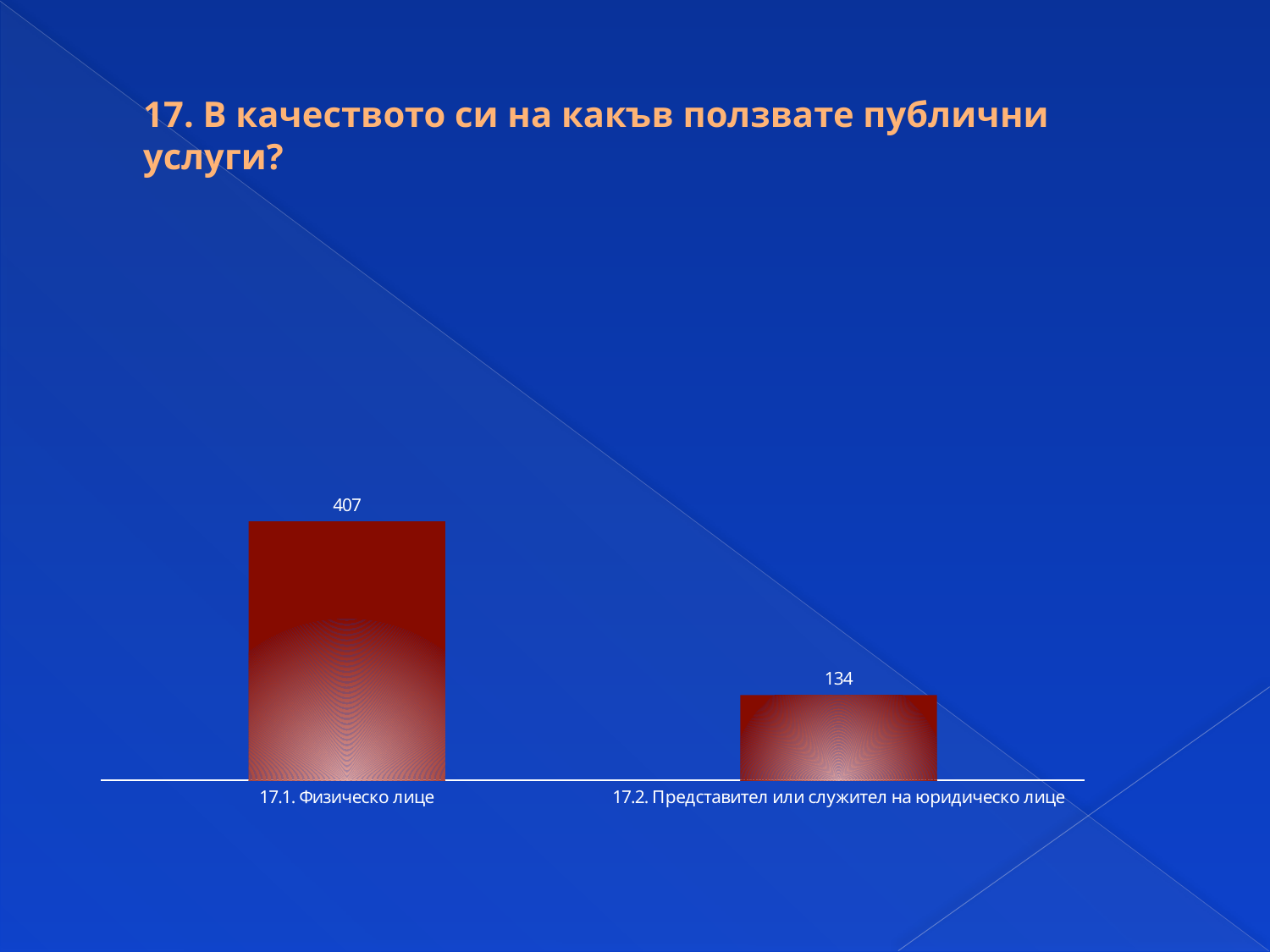
What is the difference between the values for "17.1. Физическо лице" and "17.2. Представител или служител на юридическо лице"? 273 What kind of chart is shown on the slide? bar chart What is the value for "17.2. Представител или служител на юридическо лице"? 134 What is the value for "17.1. Физическо лице"? 407 Which is larger: the value for "17.1. Физическо лице" or for "17.2. Представител или служител на юридическо лице"? 17.1. Физическо лице Do the values rise or fall from left to right along the x axis? fall Which category has the highest value? 17.1. Физическо лице Which category has the lowest value? 17.2. Представител или служител на юридическо лице What is the total of the two values shown in the chart? 541 What colour are the bars in the chart? red How many categories are shown in the chart? 2 What is the title of the slide containing the chart? 17. В качеството си на какъв ползвате публични услуги?